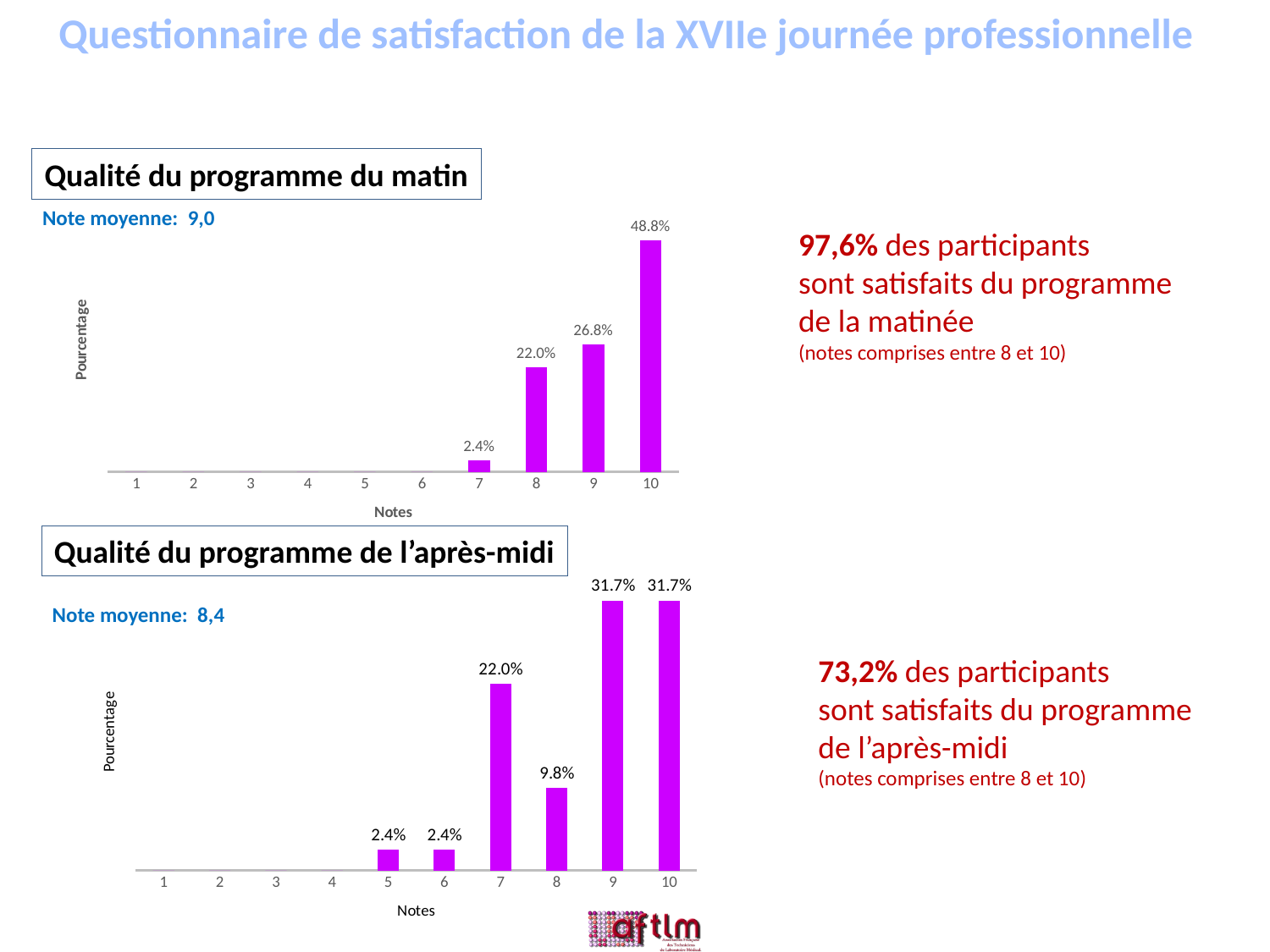
What is the label of the y axis in the 'Qualité du programme du matin' chart? Pourcentage How many notes are shown on the x axis of the 'Qualité du programme de l'après-midi' chart? 10 In the 'Qualité du programme de l'après-midi' chart, what percentage is shown for note 7? 22.0% In the 'Qualité du programme de l'après-midi' chart, what is the difference between the percentages for note 9 and note 8? 21.9% In the 'Qualité du programme de l'après-midi' chart, what percentage is shown for note 8? 9.8% In the 'Qualité du programme du matin' chart, what is the difference between the percentages for note 10 and note 9? 22.0% What kind of chart is the 'Qualité du programme du matin' chart? bar chart In the 'Qualité du programme du matin' chart, what percentage is shown for note 8? 22.0% In the 'Qualité du programme de l'après-midi' chart, which is larger, the percentage for note 7 or for note 8? note 7 In the 'Qualité du programme du matin' chart, which note has the highest percentage? 10 In the 'Qualité du programme du matin' chart, what percentage is shown for note 10? 48.8% In the 'Qualité du programme du matin' chart, which is larger, the percentage for note 8 or for note 9? note 9